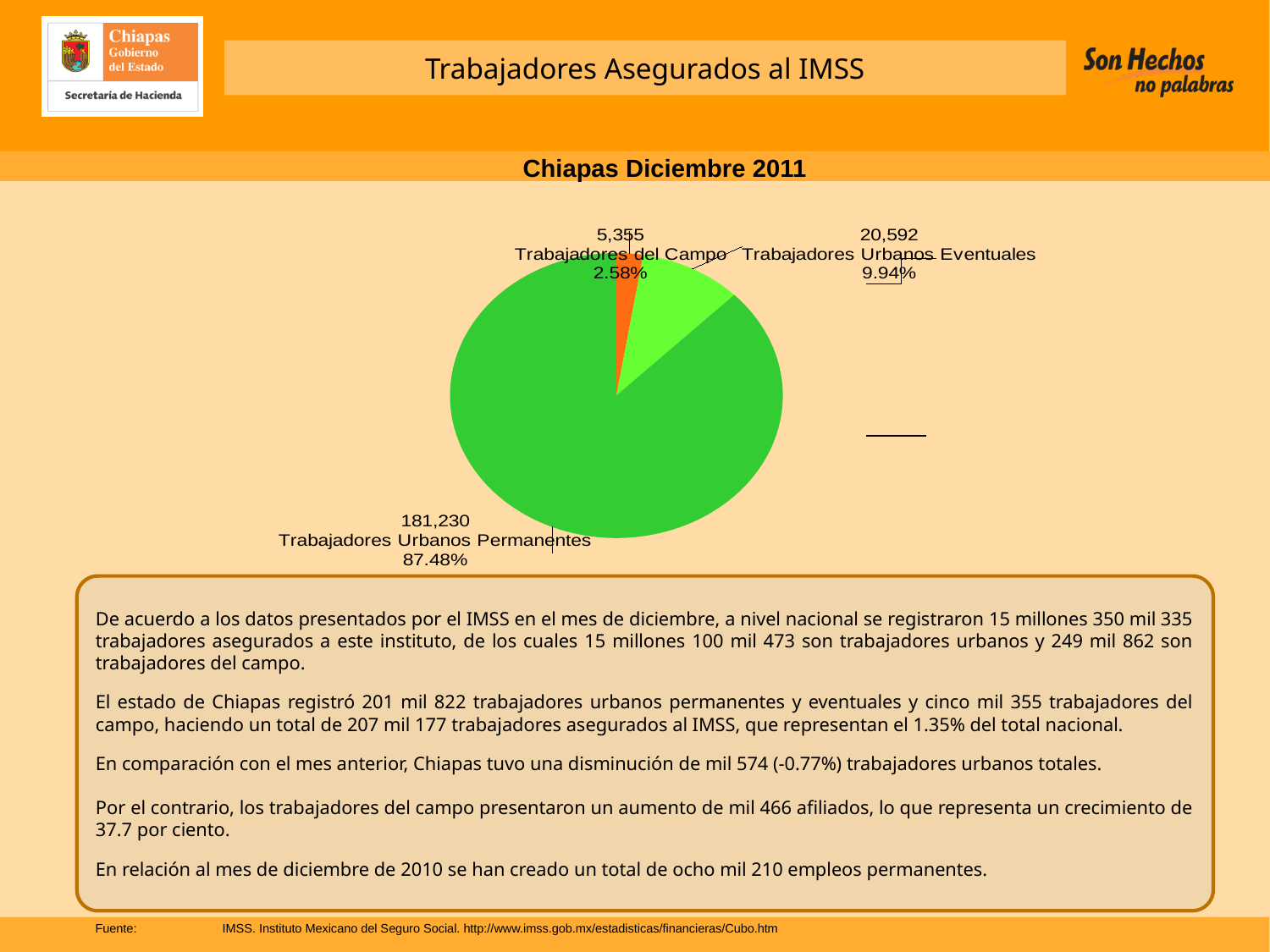
What is the value for Trabajadores Urbanos Permanentes? 181,230 Which category has the smallest slice of the pie? Trabajadores del Campo What share of the pie does Trabajadores Urbanos Eventuales represent? 9.94% What is the value for Trabajadores Urbanos Eventuales? 20,592 What kind of chart is shown on the slide? Pie chart What is the value for Trabajadores del Campo? 5,355 What is the difference between the values for Trabajadores Urbanos Eventuales and Trabajadores del Campo? 15,237 What share of the pie does Trabajadores Urbanos Permanentes represent? 87.48% What is the title shown above the pie chart? Chiapas Diciembre 2011 What share of the pie does Trabajadores del Campo represent? 2.58% How many slices does the pie chart have? 3 Which category has the largest slice of the pie? Trabajadores Urbanos Permanentes